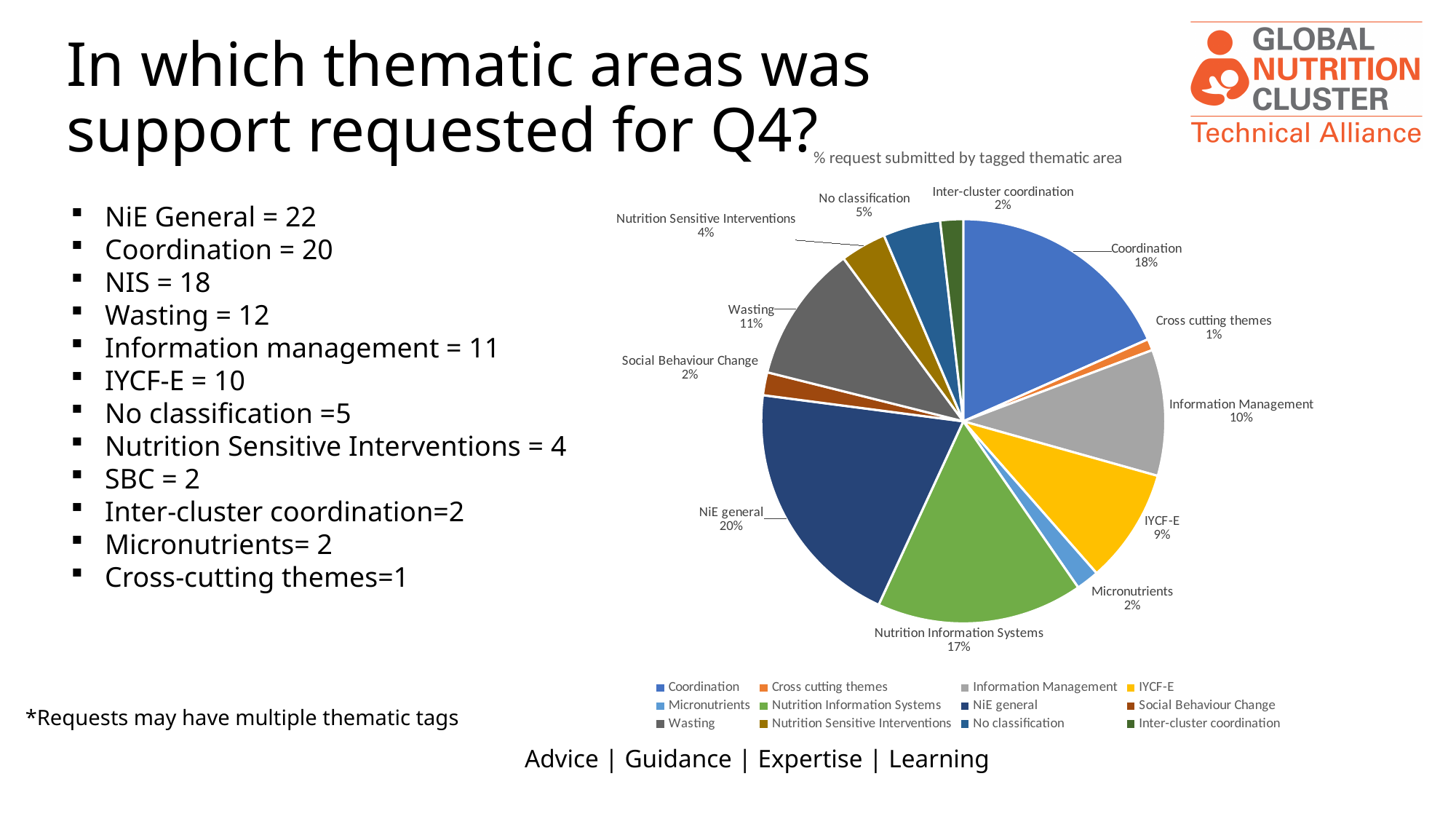
What percentage of requests is shown for NiE general? 20% How many thematic areas does the legend list? 12 What type of chart is shown on the slide? Pie chart What percentage of requests is shown for No classification? 5% What percentage of requests is shown for Nutrition Information Systems? 17% What percentage of requests is shown for Coordination? 18% Which thematic area has the largest share of the pie? NiE general What is the difference in percentage points between Coordination and Information Management? 8 Which has a larger share, IYCF-E or Wasting? Wasting Which thematic area has the smallest share of the pie? Cross cutting themes What percentage of requests is shown for Wasting? 11% What is the title of the chart? % request submitted by tagged thematic area